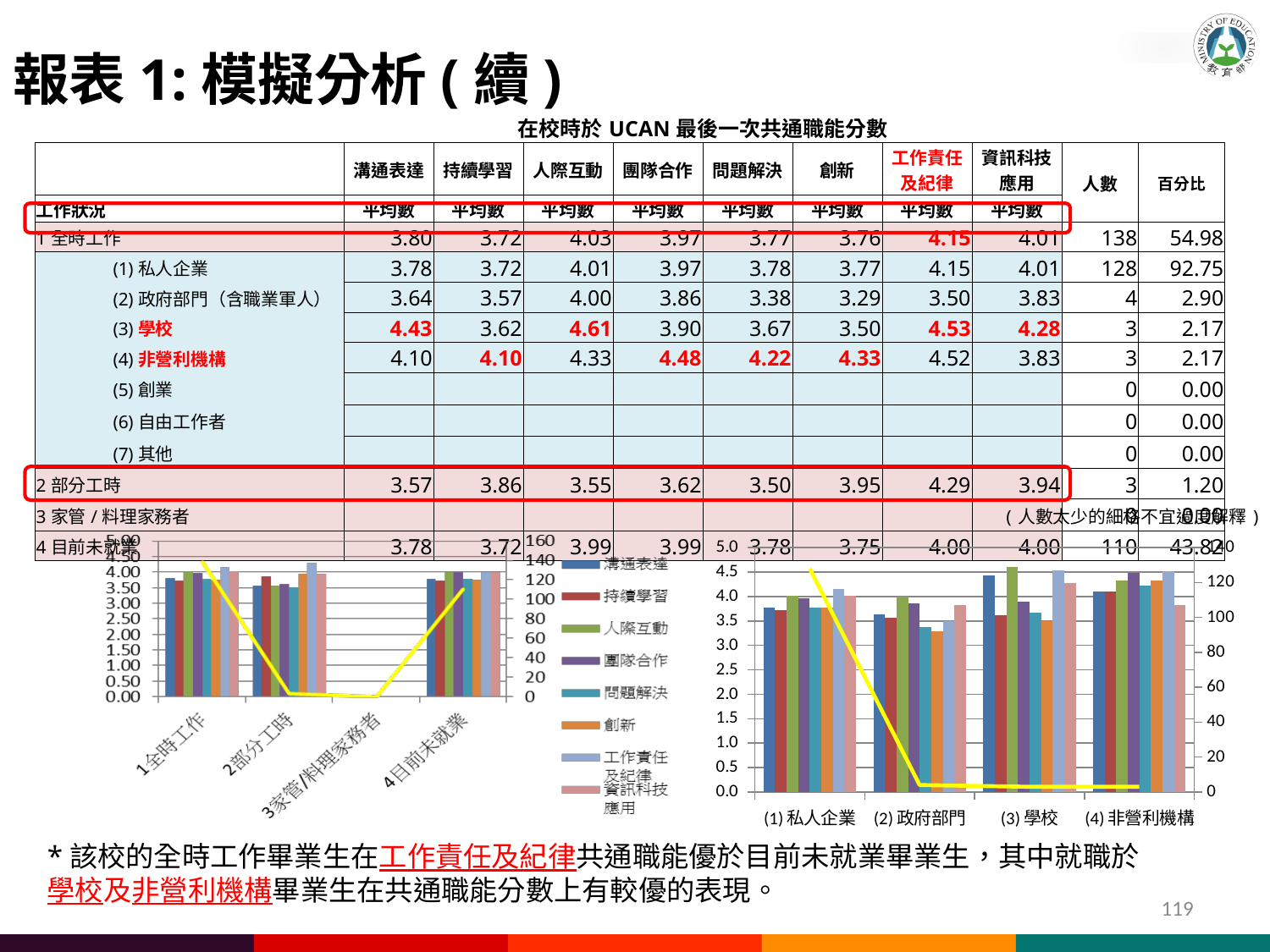
How many categories are shown on the x axis of the right chart (私人企業 to 非營利機構)? 4 In the right chart, which category has the lowest 創新 value? (2) 政府部門 In the right chart, what is the 溝通表達 value for (3) 學校? 4.43 How many categories are shown on the x axis of the left chart? 4 What is the maximum tick value on the right-hand axis of the right chart? 140 In the right chart, which category has the highest 溝通表達 value? (3) 學校 How many series does the legend between the two charts list? 8 In the right chart, is the 人際互動 value for (3) 學校 greater or less than 4.5? greater In the left chart, which is larger for 創新: 1全時工作 or 2部分工時? 2部分工時 In the right chart, is the 問題解決 value for (2) 政府部門 greater or less than 3.5? less In the left chart, what is the difference in 工作責任及紀律 between 1全時工作 and 4目前未就業? 0.15 What kind of chart is the chart on the left (categories 1全時工作 to 4目前未就業)? combination bar and line chart